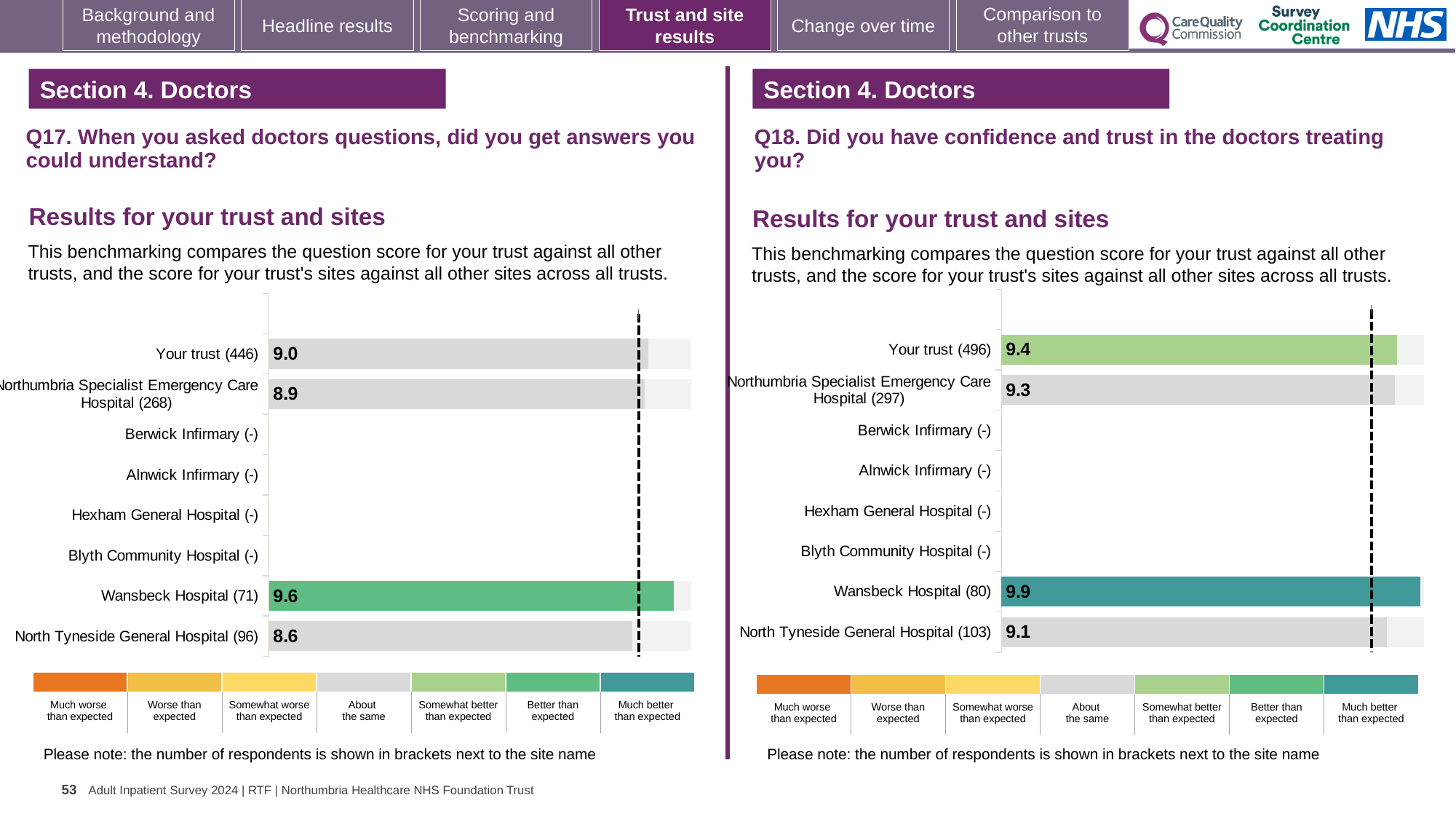
In the Q18 chart on the right, what is the difference between the scores for Wansbeck Hospital (80) and Your trust (496)? 0.5 In the Q18 chart on the right, which has the larger score: Your trust (496) or Northumbria Specialist Emergency Care Hospital (297)? Your trust (496) In the Q18 chart on the right, what is the score for North Tyneside General Hospital (103)? 9.1 In the Q17 chart on the left, what is the score for Wansbeck Hospital (71)? 9.6 In the Q17 chart on the left, which site has the lowest score shown? North Tyneside General Hospital (96) In the Q17 chart on the left, what is the difference between the scores for Wansbeck Hospital (71) and North Tyneside General Hospital (96)? 1.0 How many site/trust categories are listed on the y axis of the Q17 chart on the left? 8 In the Q18 chart on the right, what is the score for Your trust (496)? 9.4 In the Q18 chart on the right, which site has the highest score shown? Wansbeck Hospital (80) In the Q17 chart on the left, what benchmark category does the colour of the Wansbeck Hospital (71) bar correspond to in the key? Better than expected In the Q17 chart on the left, what is the score for Your trust (446)? 9.0 What kind of chart is used for the Q18 results on the right? Bar chart